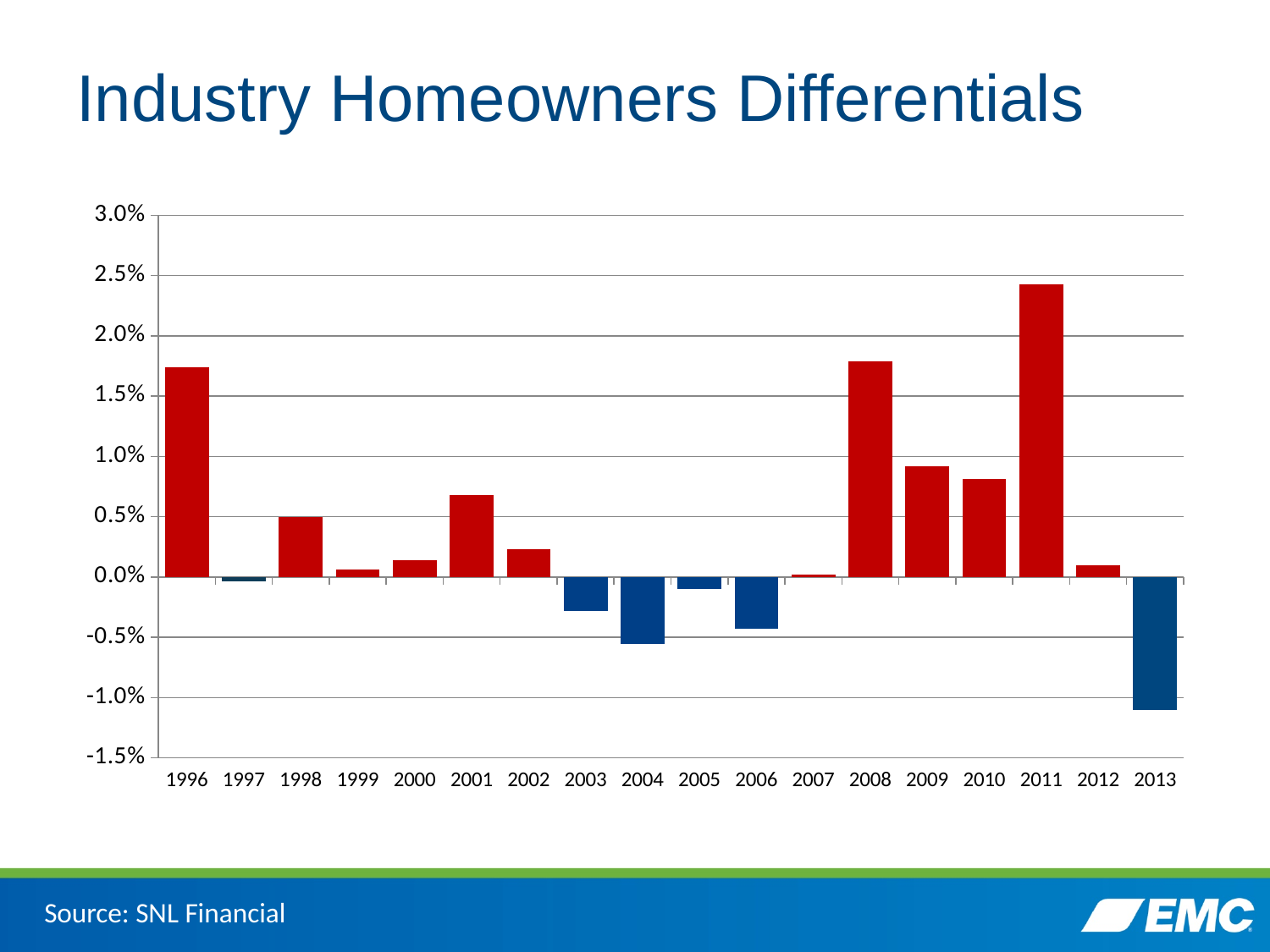
Is the value for 1996 greater or less than 1.5%? greater Is the value for 2001 greater or less than 0.5%? greater What kind of chart is shown on the slide? bar chart What is the title of the chart? Industry Homeowners Differentials Which year has the lowest value in the chart? 2013 Which year has the larger value, 2011 or 2008? 2011 Which year has the highest value in the chart? 2011 How many years are shown on the x axis of the chart? 18 Is the value for 2009 greater or less than 1.0%? less How many years in the chart have a negative value (blue bars)? 6